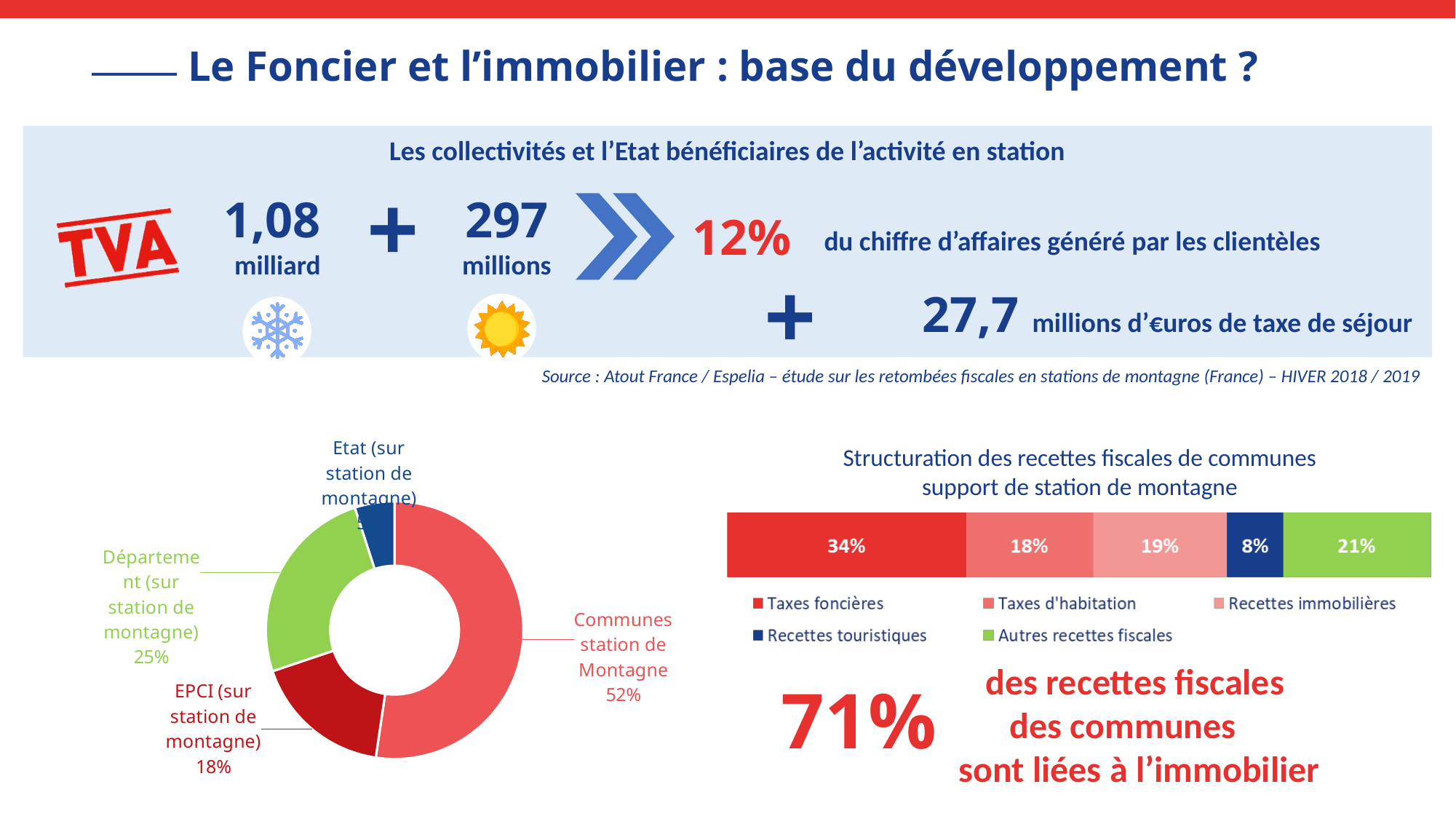
In the donut chart on the left, what is the difference between the shares of Département and EPCI? 7% In the donut chart on the left, what share is shown for EPCI (sur station de montagne)? 18% In the donut chart on the left, which category has the largest share? Communes station de Montagne In the chart titled 'Structuration des recettes fiscales de communes support de station de montagne', what percentage is shown for Taxes foncières? 34% In the chart titled 'Structuration des recettes fiscales de communes support de station de montagne', what is the difference between Taxes foncières and Autres recettes fiscales? 13% In the donut chart on the left, what share is shown for Département (sur station de montagne)? 25% In the chart titled 'Structuration des recettes fiscales de communes support de station de montagne', which category has the smallest percentage? Recettes touristiques In the chart titled 'Structuration des recettes fiscales de communes support de station de montagne', what percentage is shown for Recettes touristiques? 8% In the donut chart on the left, what share is shown for Communes station de Montagne? 52% In the donut chart on the left, which is larger: the share for Département or the share for EPCI? Département In the chart titled 'Structuration des recettes fiscales de communes support de station de montagne', how many series does the legend list? 5 What kind of chart is the one on the right titled 'Structuration des recettes fiscales de communes support de station de montagne'? Stacked bar chart